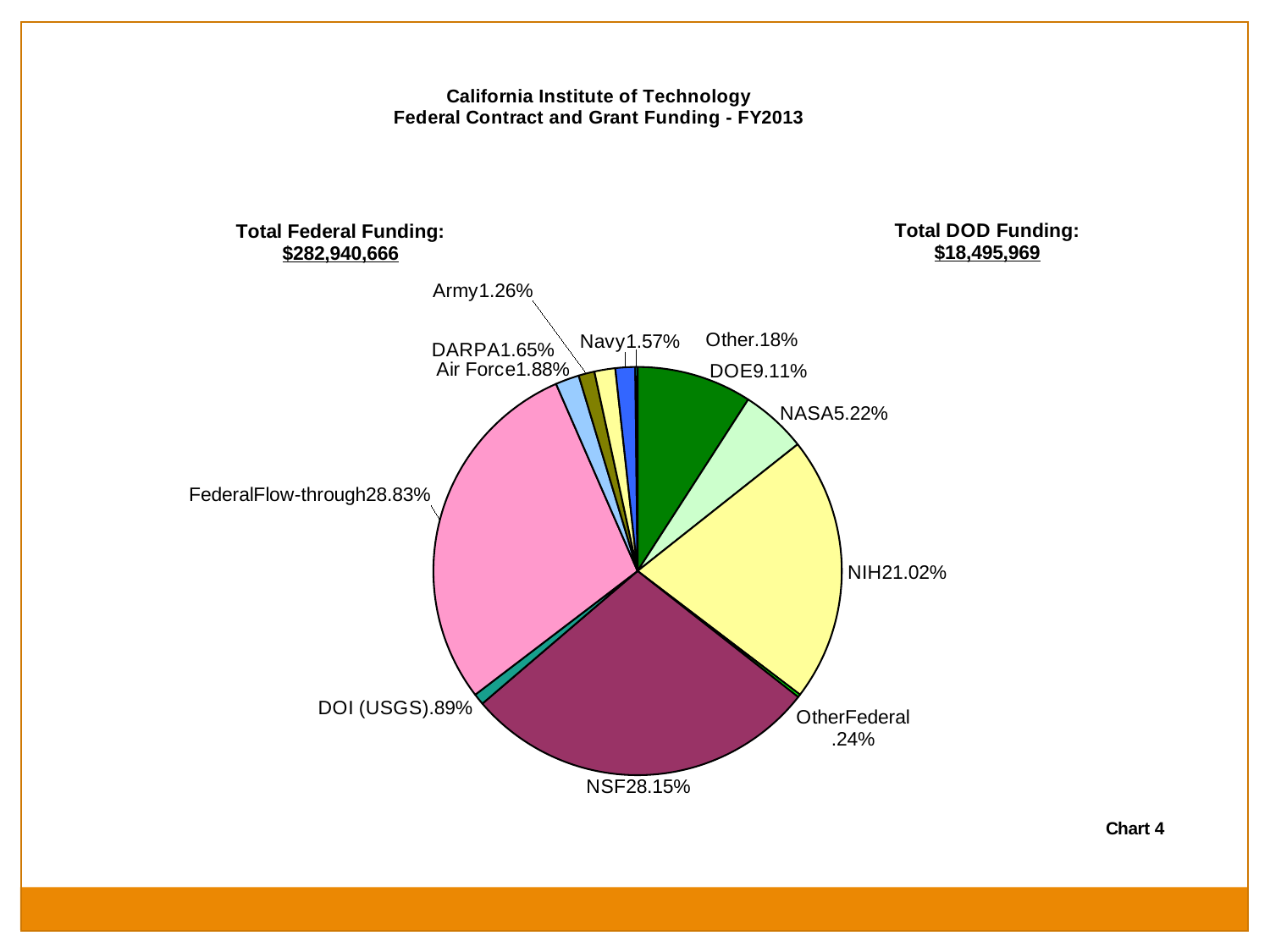
What is the difference in percentage points between Federal Flow-through and NSF? 0.68 What is the Total Federal Funding amount stated on the slide? $282,940,666 What percentage is shown for NASA? 5.22% Which is larger, the share for Air Force or the share for Army? Air Force Which category has the largest slice of the pie? Federal Flow-through What kind of chart is shown on the slide? Pie chart What share of the pie does NIH represent? 21.02% How many slices does the pie chart have? 12 What percentage is shown for DOE? 9.11% What is the Total DOD Funding amount stated on the slide? $18,495,969 Which category has the smallest slice of the pie? Other What share of the pie does NSF represent? 28.15%